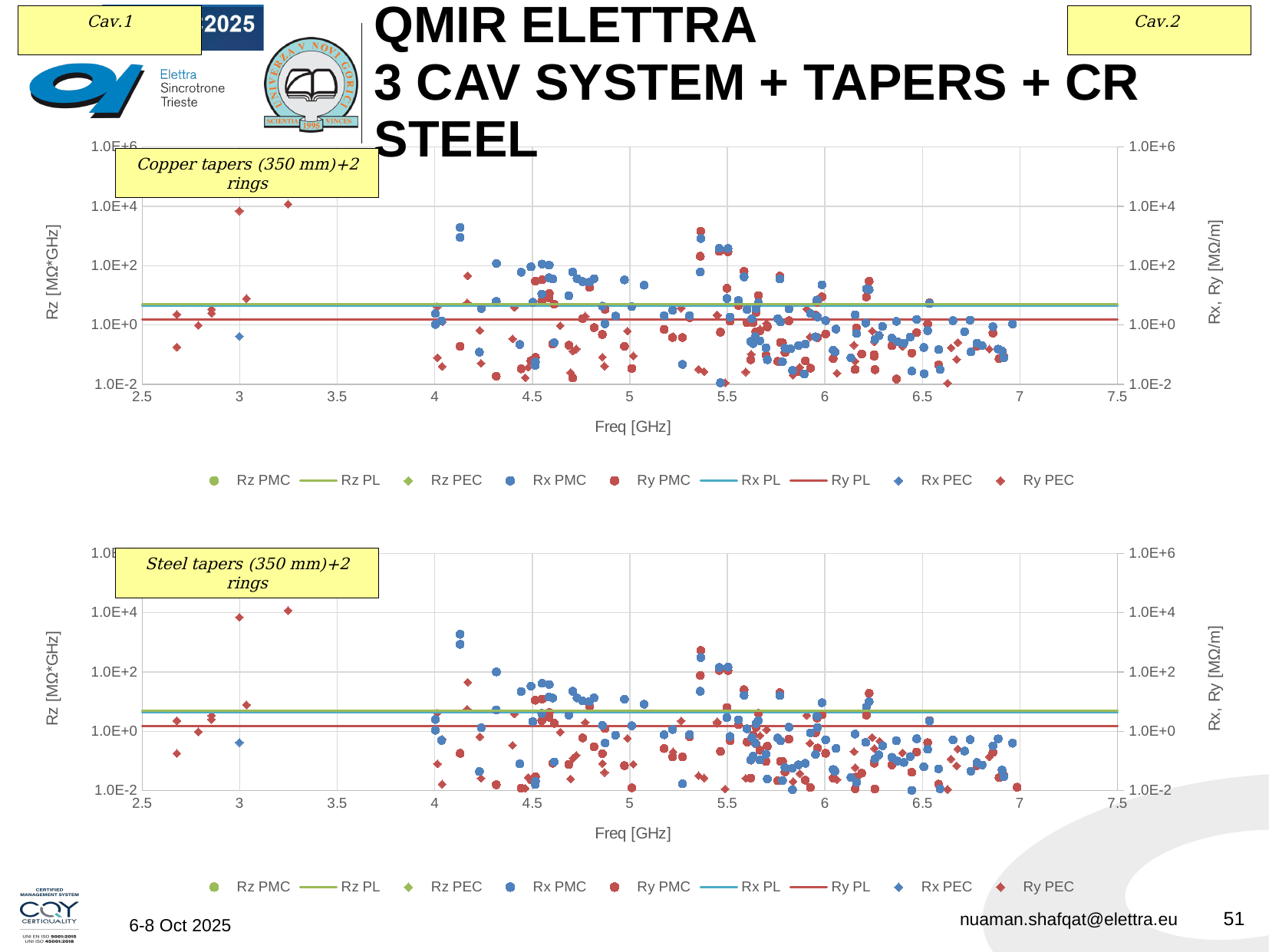
What is the x-axis label of the top chart 'Copper tapers (350 mm)+2 rings'? Freq [GHz] What kind of chart is the bottom chart titled 'Steel tapers (350 mm)+2 rings'? scatter chart What is the title of the bottom chart on the slide? Steel tapers (350 mm)+2 rings What kind of chart is the top chart titled 'Copper tapers (350 mm)+2 rings'? scatter chart How many series does the legend of the bottom chart 'Steel tapers (350 mm)+2 rings' list? 9 How many series does the legend of the top chart 'Copper tapers (350 mm)+2 rings' list? 9 In the bottom chart 'Steel tapers (350 mm)+2 rings', is the Ry PEC value at about 3.25 GHz greater or less than 1.0E+2? greater In the top chart 'Copper tapers (350 mm)+2 rings', are the Rx PMC values near 4.15 GHz greater or less than 1.0E+2? greater